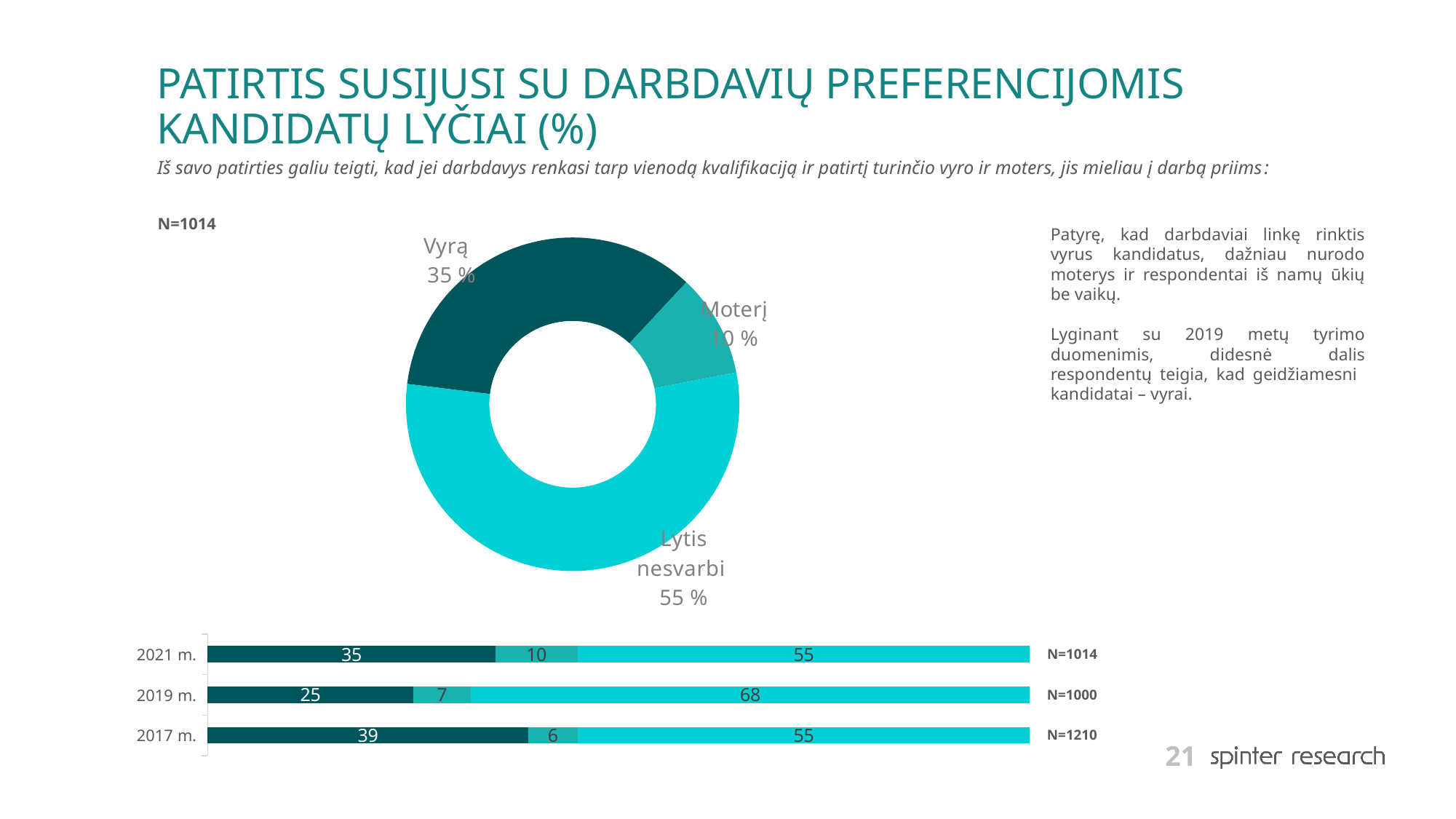
In the donut chart, what share of respondents answered "Vyrą"? 35 % In the donut chart, what share of respondents answered "Moterį"? 10 % In the stacked bar chart at the bottom, what is the value of the last (light cyan) segment for 2019 m.? 68 In the donut chart, how many categories are shown? 3 What kind of chart is the upper chart on the slide? Donut (pie) chart In the stacked bar chart at the bottom, what is the difference between the first segment values for 2017 m. and 2019 m.? 14 In the donut chart, which category has the largest share? Lytis nesvarbi In the stacked bar chart at the bottom, what is the value of the first (dark teal) segment for 2019 m.? 25 In the stacked bar chart at the bottom, what is the value of the middle segment for 2017 m.? 6 In the stacked bar chart at the bottom, how many years (bars) are shown? 3 In the stacked bar chart at the bottom, which year has the larger first (dark teal) segment, 2021 m. or 2019 m.? 2021 m. In the donut chart, which category has the smallest share? Moterį